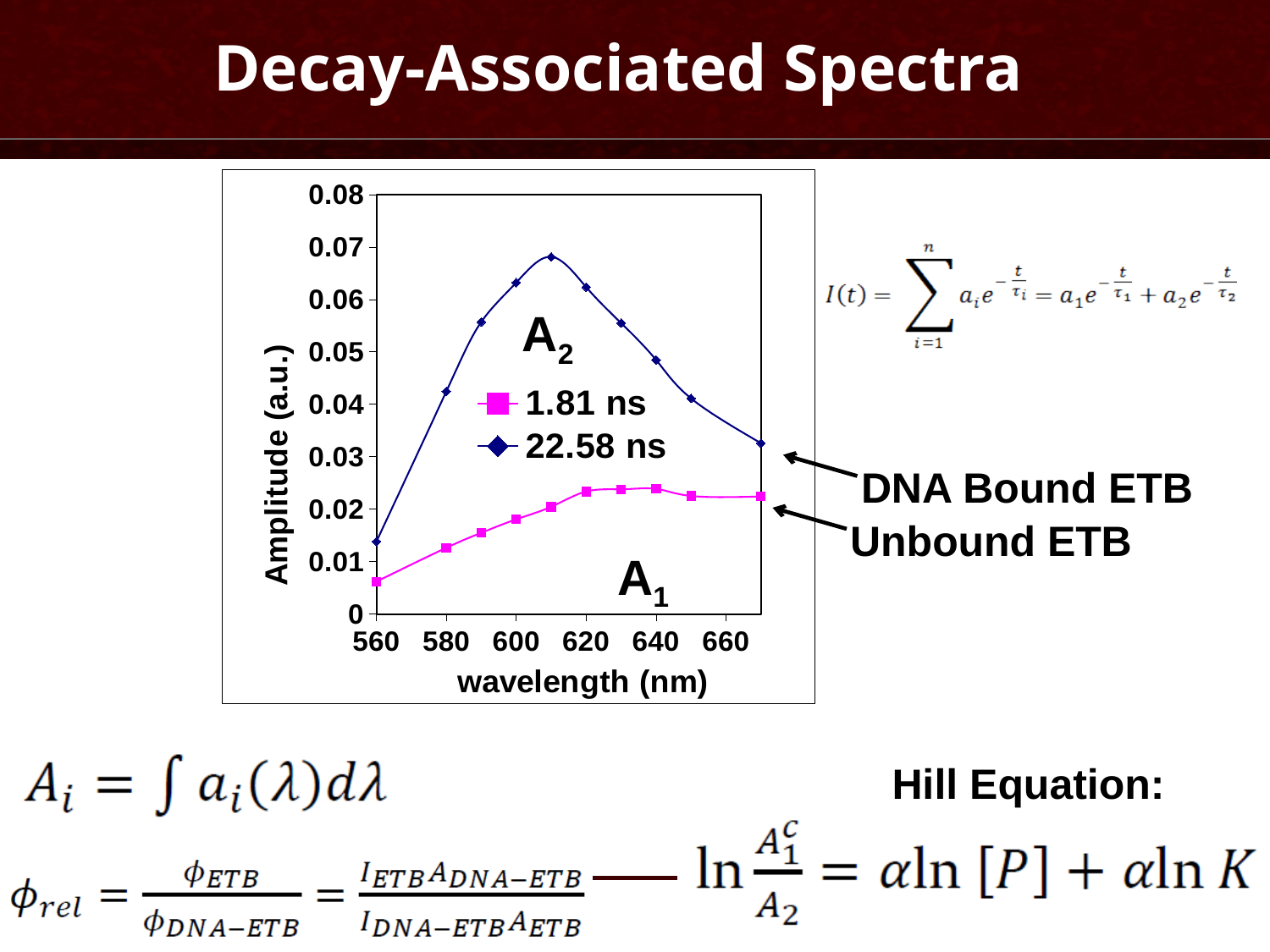
How many series does the chart legend list? 2 Is the value of the 1.81 ns series at 600 nm greater or less than 0.02? less Is the peak value of the 22.58 ns series greater or less than 0.06? greater What kind of chart is shown on the slide? line chart At which wavelength does the 22.58 ns series reach its highest amplitude? 610 What are the two series named in the chart legend? 1.81 ns and 22.58 ns Does the 22.58 ns series rise or fall between 610 nm and 670 nm? fall What is the label of the y axis of the chart? Amplitude (a.u.) Does the 1.81 ns series rise or fall between 560 nm and 640 nm? rise At 620 nm, which series has the larger amplitude, 1.81 ns or 22.58 ns? 22.58 ns Is the value of the 1.81 ns series at 560 nm greater or less than 0.01? less